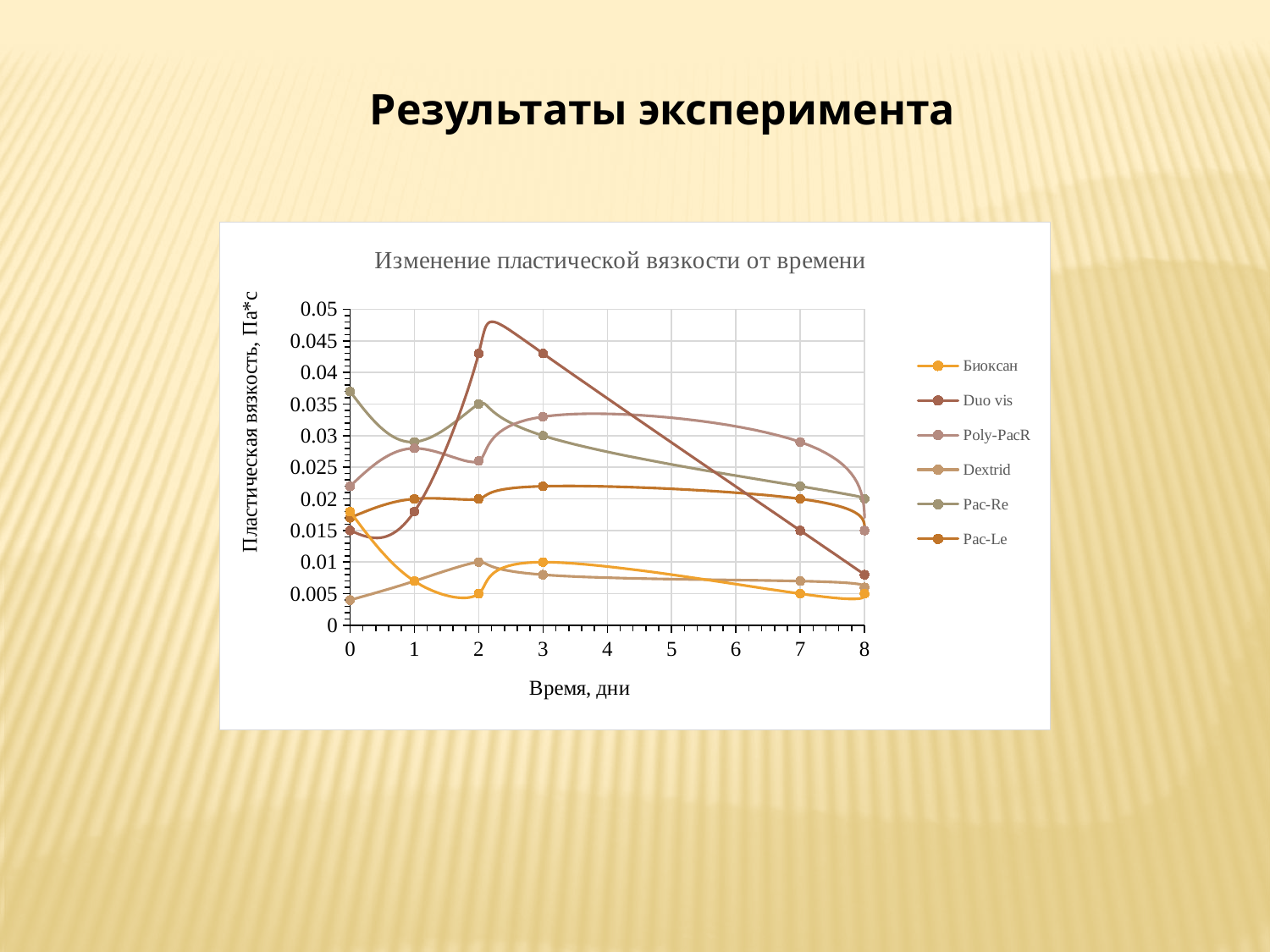
Which is larger at day 8: Poly-PacR or Duo vis? Poly-PacR What is the label of the vertical axis? Пластическая вязкость, Па*с What is the title of the chart? Изменение пластической вязкости от времени What kind of chart is shown on the slide? line chart What is the value of Pac-Re at day 3? 0.03 How many series does the legend list? 6 How many data points are plotted for each series? 6 Which series has the highest value at day 3? Duo vis Which series has the lowest value at day 0? Dextrid Does the Duo vis series rise or fall between day 3 and day 8? fall Is the value of Duo vis at day 2 greater or less than 0.04? greater What is the value of Pac-Le at day 1? 0.02